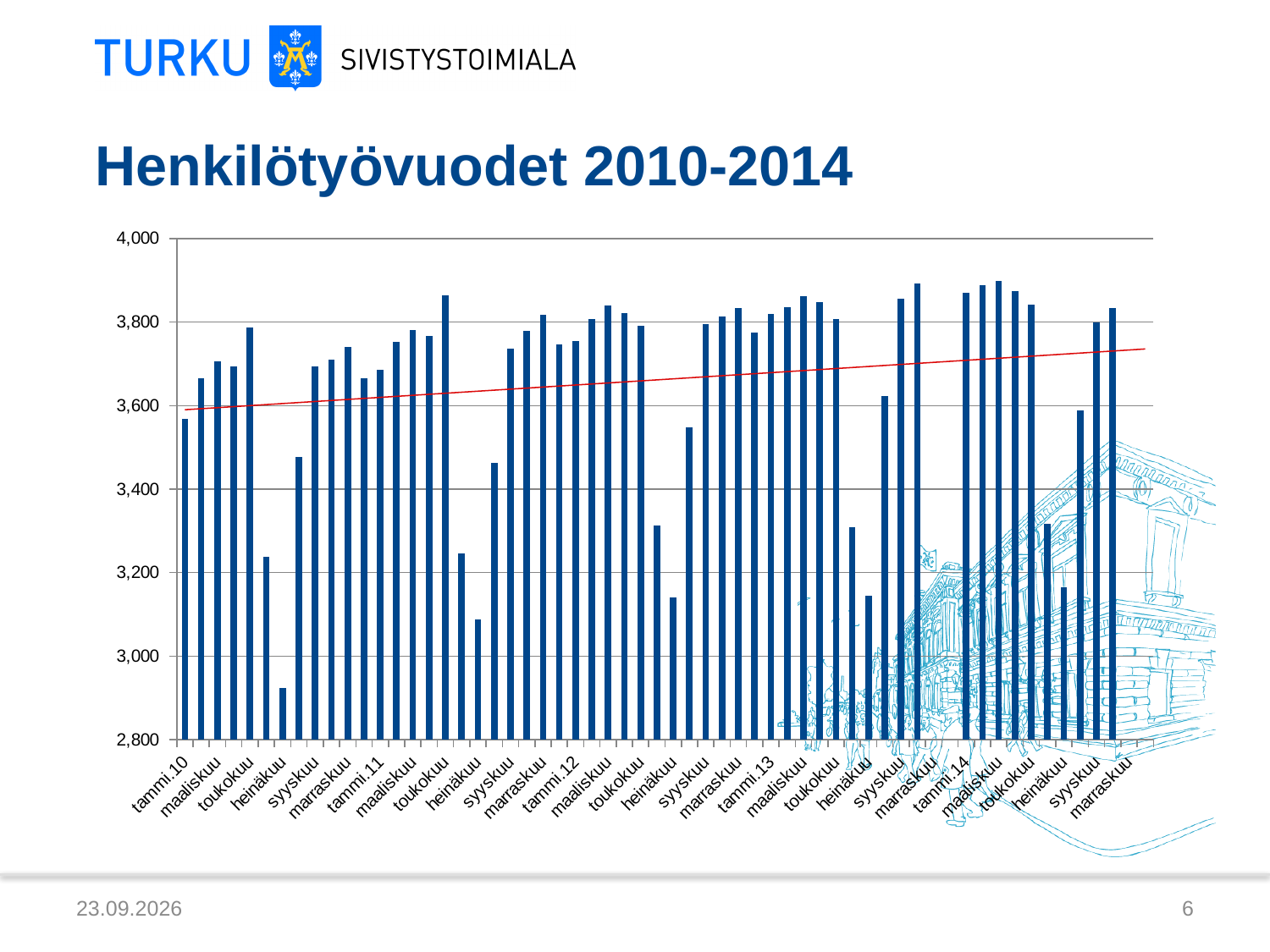
What is the title of the chart? Henkilötyövuodet 2010-2014 What is the highest value shown on the vertical axis? 4,000 Is the value for toukokuu in 2010 (the first toukokuu label) greater or less than 3,600? greater What kind of chart is shown on the slide? bar chart Is the value for tammi.10 greater or less than 3,400? greater Which is larger, the value for tammi.10 or the value for the first heinäkuu (2010)? tammi.10 Is the value for heinäkuu in 2010 (the first heinäkuu label) greater or less than 3,400? less Does the red trend line rise or fall from left to right? rises What colour is the trend line drawn across the bars? red